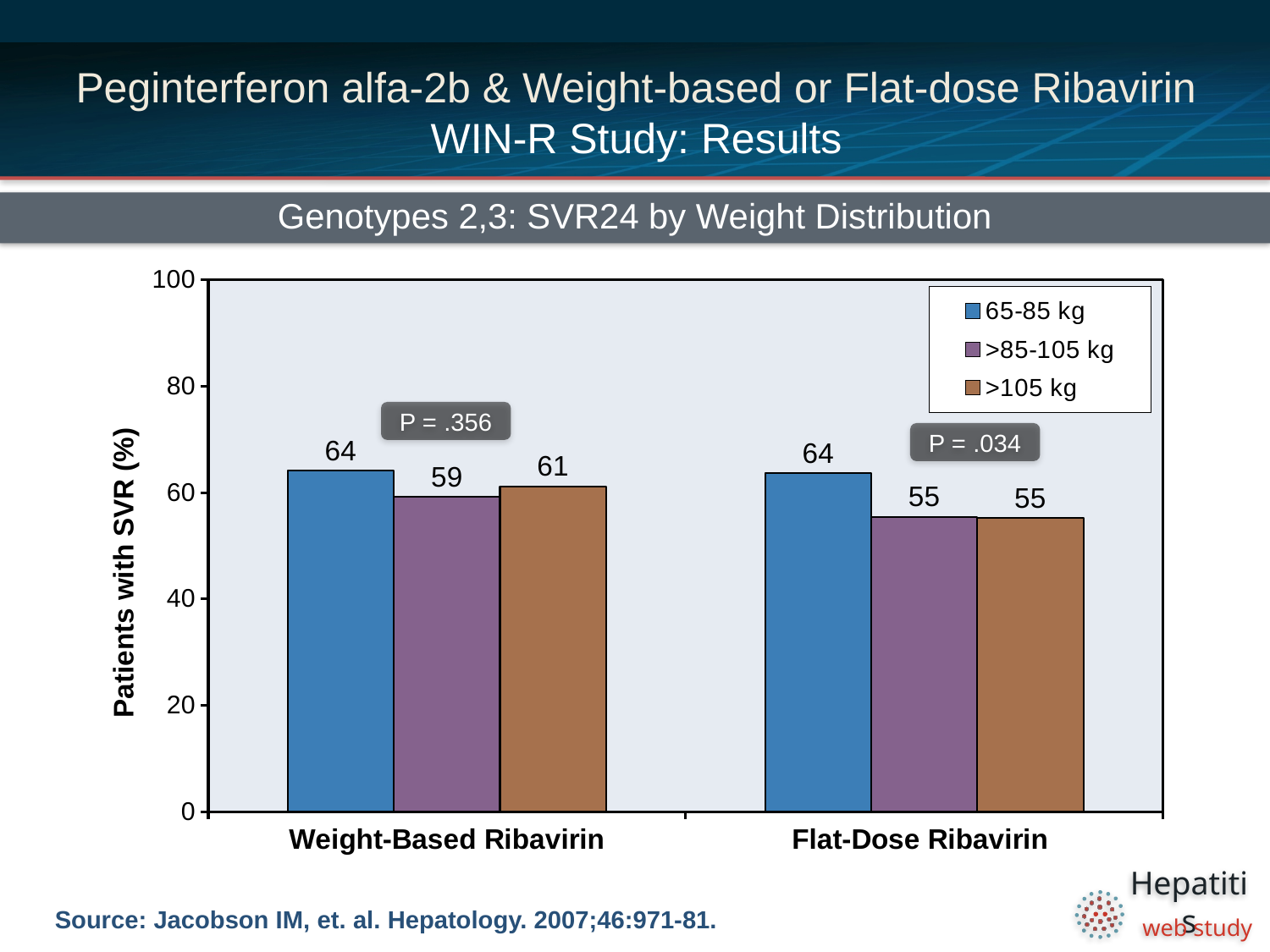
What is the difference in SVR rate between the >105 kg group with Weight-Based Ribavirin and the >105 kg group with Flat-Dose Ribavirin? 6 Which is larger: the SVR rate for the >85-105 kg group with Weight-Based Ribavirin or with Flat-Dose Ribavirin? Weight-Based Ribavirin What P value is shown for the Flat-Dose Ribavirin group? P = .034 What is the SVR rate for the 65-85 kg group with Weight-Based Ribavirin? 64 Which weight group has the lowest SVR rate with Weight-Based Ribavirin? >85-105 kg How many series does the legend list? 3 What is the SVR rate for the >85-105 kg group with Flat-Dose Ribavirin? 55 What is the SVR rate for the >105 kg group with Weight-Based Ribavirin? 61 How many treatment categories are shown on the x axis? 2 What kind of chart is shown on the slide? Bar chart Is the SVR rate for the 65-85 kg group with Flat-Dose Ribavirin greater or less than 60? greater Which weight group has the highest SVR rate with Flat-Dose Ribavirin? 65-85 kg